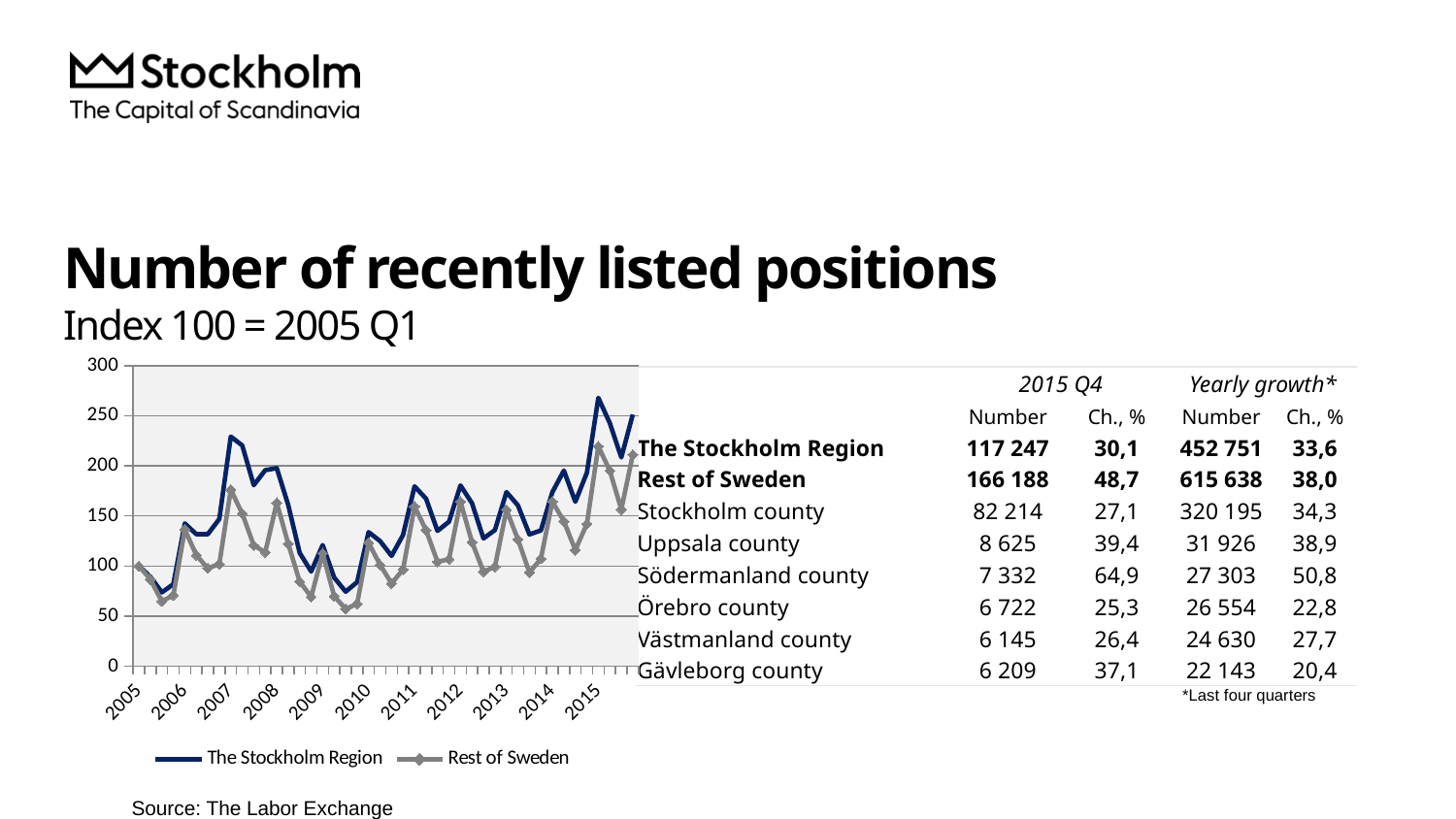
Is the value for The Stockholm Region at the start of 2010 greater or less than 150? less At the end of 2015, which series is higher, The Stockholm Region or Rest of Sweden? The Stockholm Region What is the title of the chart on the slide? Number of recently listed positions How many series does the chart legend list? 2 Around the 2007 peak, which series is higher, The Stockholm Region or Rest of Sweden? The Stockholm Region Is the value for The Stockholm Region at the end of 2015 greater or less than 200? greater How many year labels are shown on the x axis of the chart? 11 What are the two series named in the chart legend? The Stockholm Region and Rest of Sweden Is the lowest value for Rest of Sweden around 2009-2010 greater or less than 100? less What kind of chart is shown on the slide? Line chart Overall, does the value for The Stockholm Region rise or fall from 2005 to 2015? rise What is the highest value shown on the y axis of the chart? 300